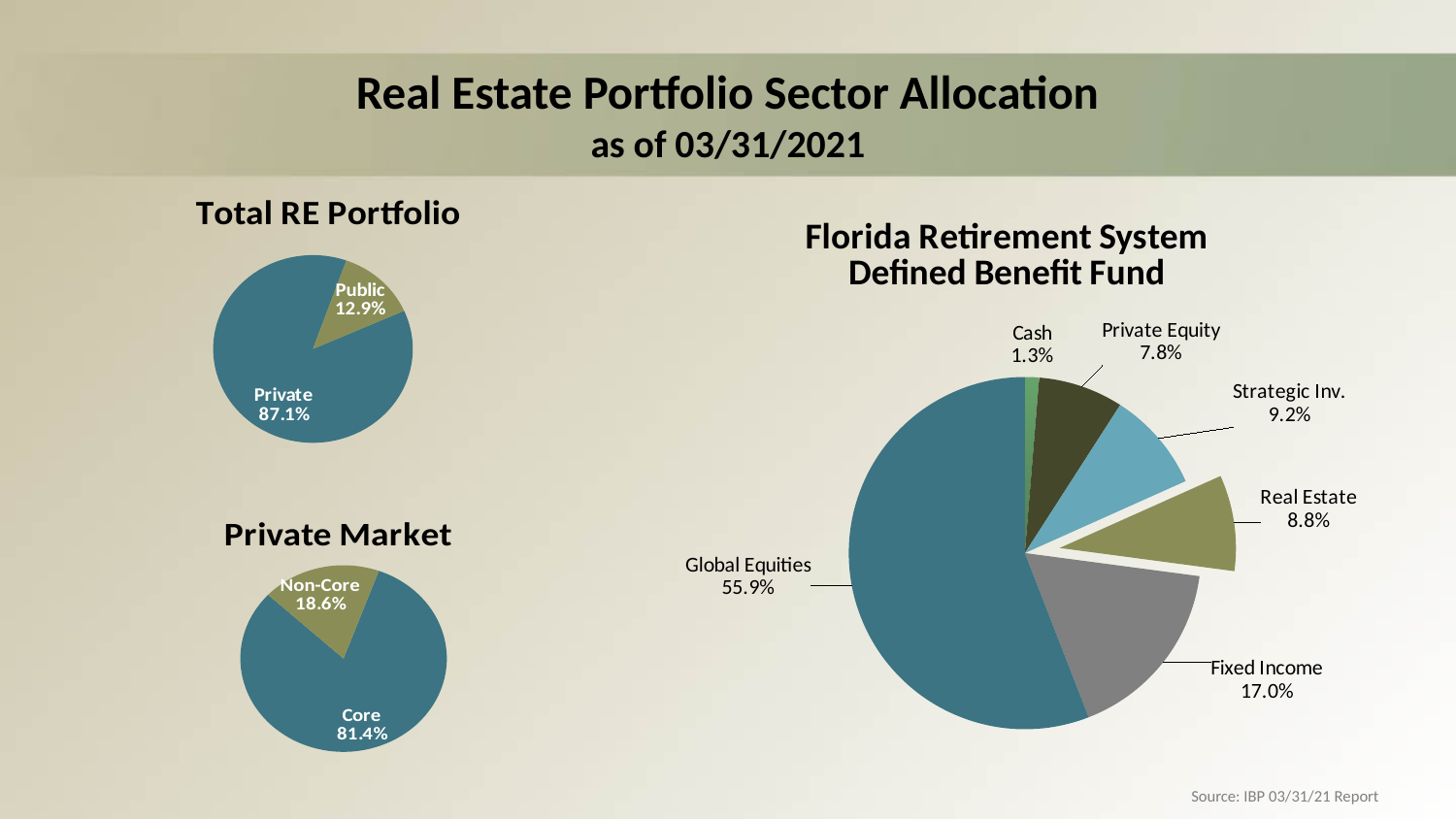
In the Total RE Portfolio pie chart, what share is Public? 12.9% In the Florida Retirement System Defined Benefit Fund pie chart, how many categories are shown? 6 In the Total RE Portfolio pie chart, what share is Private? 87.1% What kind of chart is used for the Private Market? Pie chart In the Florida Retirement System Defined Benefit Fund pie chart, which slice is pulled out from the rest of the pie? Real Estate In the Florida Retirement System Defined Benefit Fund pie chart, what is the difference between the Global Equities share and the Fixed Income share? 38.9% In the Florida Retirement System Defined Benefit Fund pie chart, which category has the largest share? Global Equities In the Private Market pie chart, what share is Non-Core? 18.6% In the Florida Retirement System Defined Benefit Fund pie chart, which category has the smallest share? Cash In the Florida Retirement System Defined Benefit Fund pie chart, which is larger, Strategic Inv. or Real Estate? Strategic Inv. In the Florida Retirement System Defined Benefit Fund pie chart, what share is Fixed Income? 17.0% In the Private Market pie chart, which slice is larger, Core or Non-Core? Core